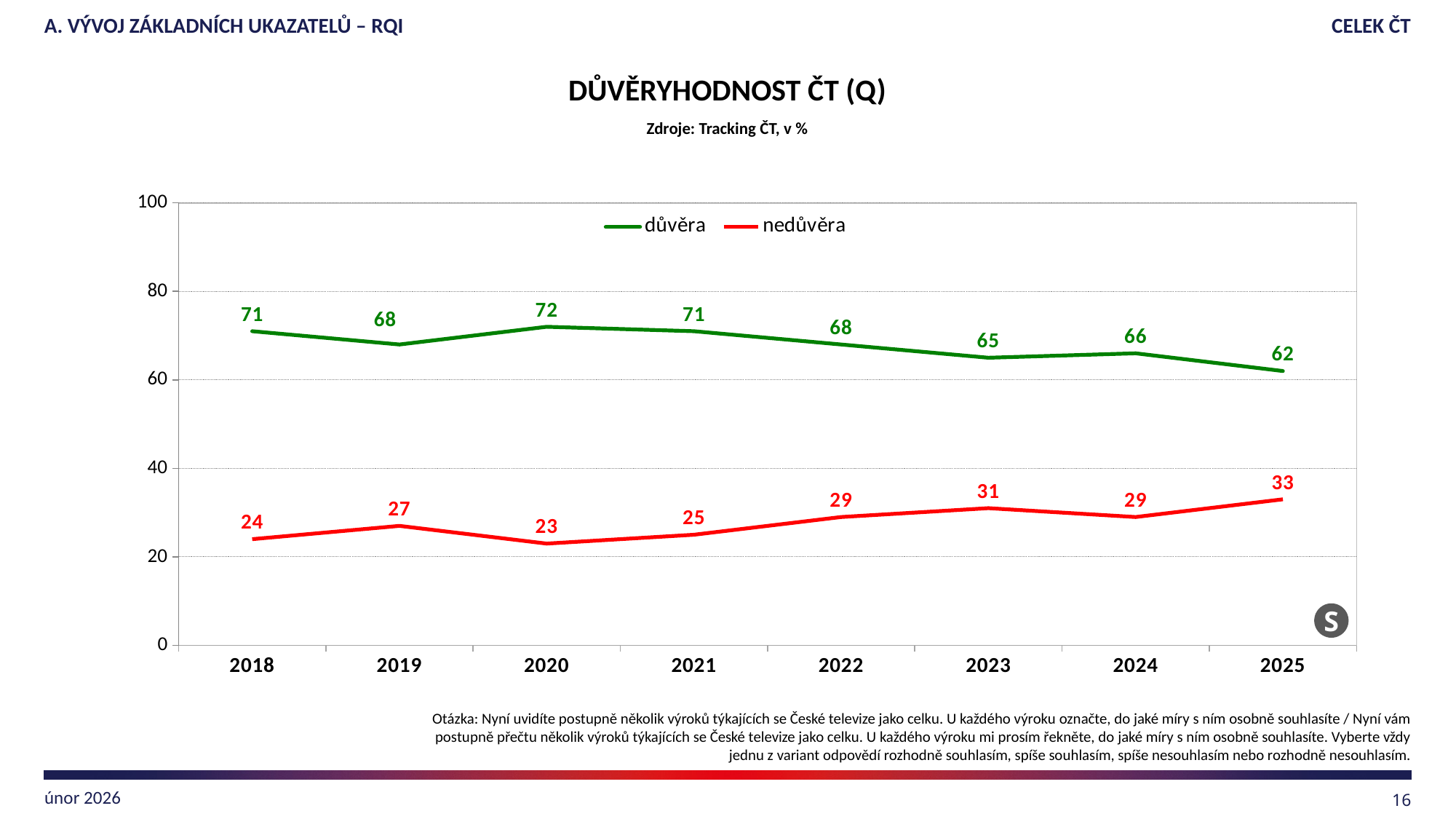
How many years are shown on the x axis? 8 In which year is nedůvěra highest? 2025 What is the value of nedůvěra in 2025? 33 Which is larger in 2023: důvěra or nedůvěra? důvěra What kind of chart is shown? line chart What is the title of the chart? DŮVĚRYHODNOST ČT (Q) What is the difference between důvěra and nedůvěra in 2018? 47 Does důvěra generally rise or fall from 2018 to 2025? fall Is the value of důvěra in 2025 greater or less than 60? greater What is the value of důvěra in 2020? 72 How many series does the legend list? 2 In which year is důvěra lowest? 2025